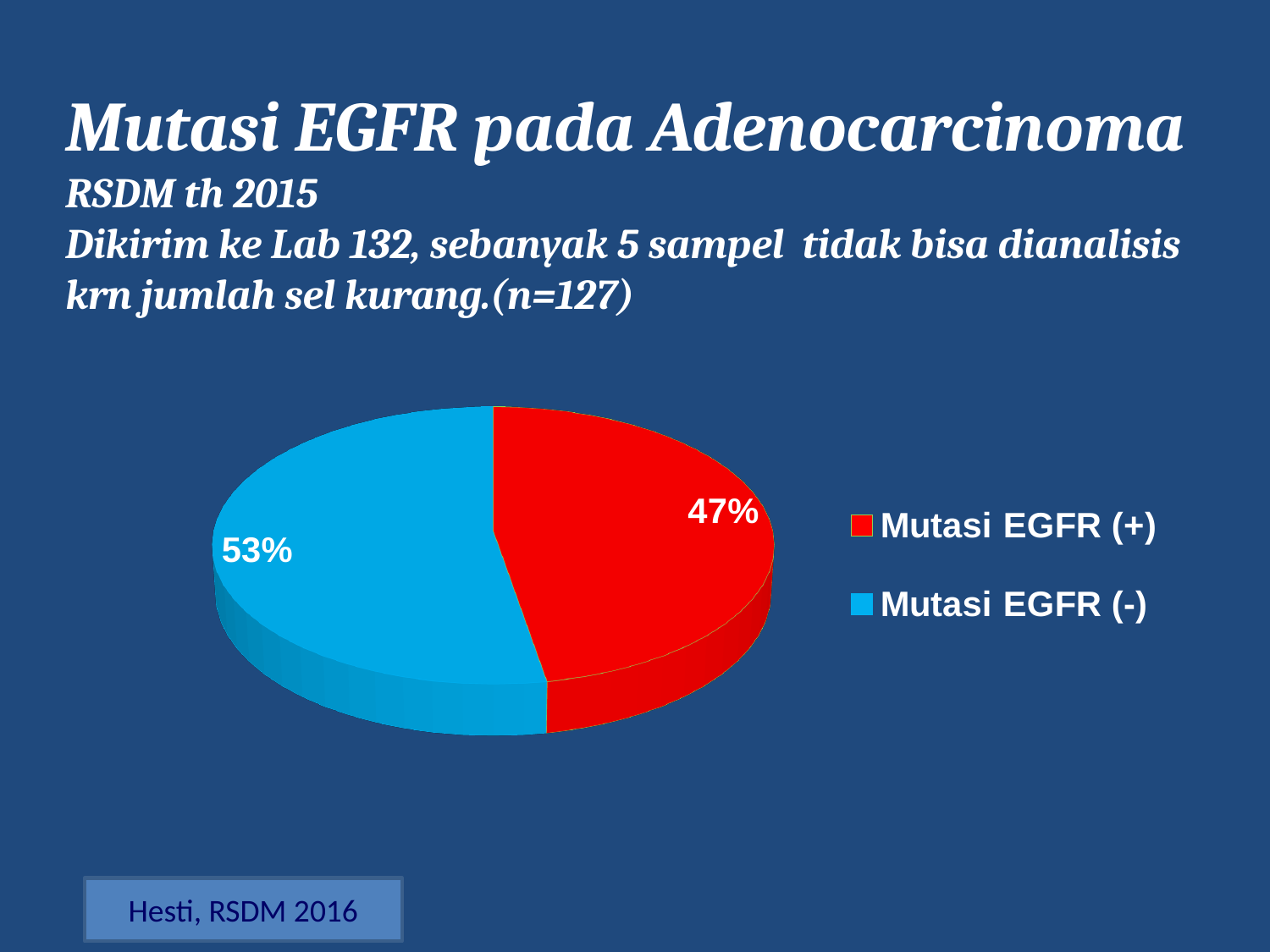
What kind of chart is shown on the slide? Pie chart What is the difference in percentage points between the Mutasi EGFR (-) slice and the Mutasi EGFR (+) slice? 6 How many slices does the pie chart have? 2 What percentage of the pie is labelled Mutasi EGFR (-)? 53% Which slice of the pie is the largest? Mutasi EGFR (-) What percentage of the pie is labelled Mutasi EGFR (+)? 47% What colour is the Mutasi EGFR (-) slice? Blue What colour is the Mutasi EGFR (+) slice? Red Which is larger, the Mutasi EGFR (+) slice or the Mutasi EGFR (-) slice? Mutasi EGFR (-) What share of the pie does the Mutasi EGFR (+) slice represent? 47% How many entries does the legend list? 2 Which slice of the pie is the smallest? Mutasi EGFR (+)